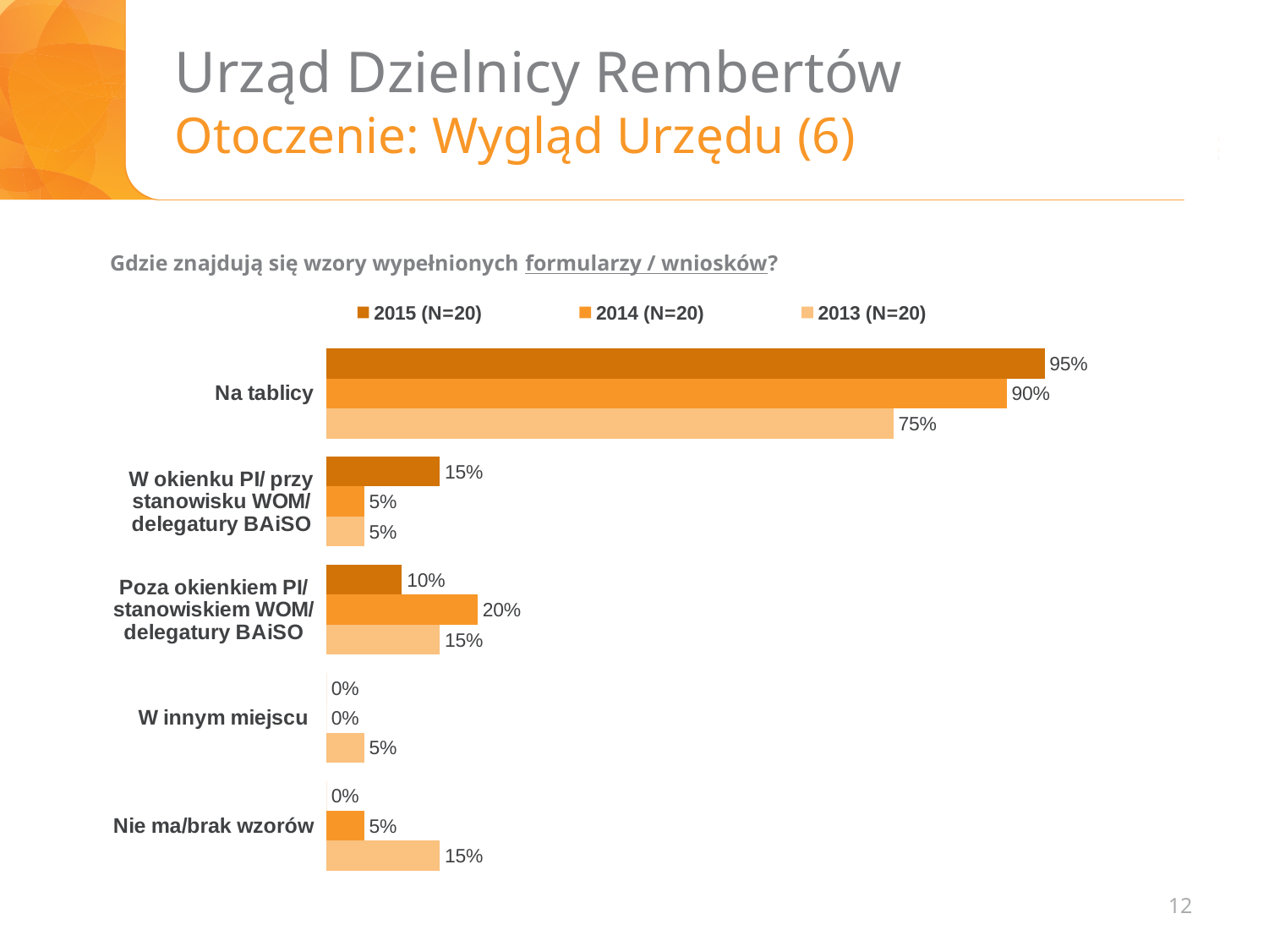
What kind of chart is shown on the slide? Bar chart What question does the chart answer, as stated above it? Gdzie znajdują się wzory wypełnionych formularzy / wniosków? What is the value for "Nie ma/brak wzorów" in the 2013 (N=20) series? 15% Which is larger for "Poza okienkiem PI/ stanowiskiem WOM/ delegatury BAiSO": the 2014 (N=20) value or the 2015 (N=20) value? 2014 (N=20) How many series does the legend list? 3 What is the value for "Na tablicy" in the 2015 (N=20) series? 95% What is the value for "Na tablicy" in the 2013 (N=20) series? 75% What is the difference between the 2015 (N=20) and 2013 (N=20) values for "Na tablicy"? 20% What is the value for "Poza okienkiem PI/ stanowiskiem WOM/ delegatury BAiSO" in the 2014 (N=20) series? 20% How many categories are shown on the chart? 5 What is the value for "W innym miejscu" in the 2015 (N=20) series? 0% Which category has the highest value in the 2015 (N=20) series? Na tablicy